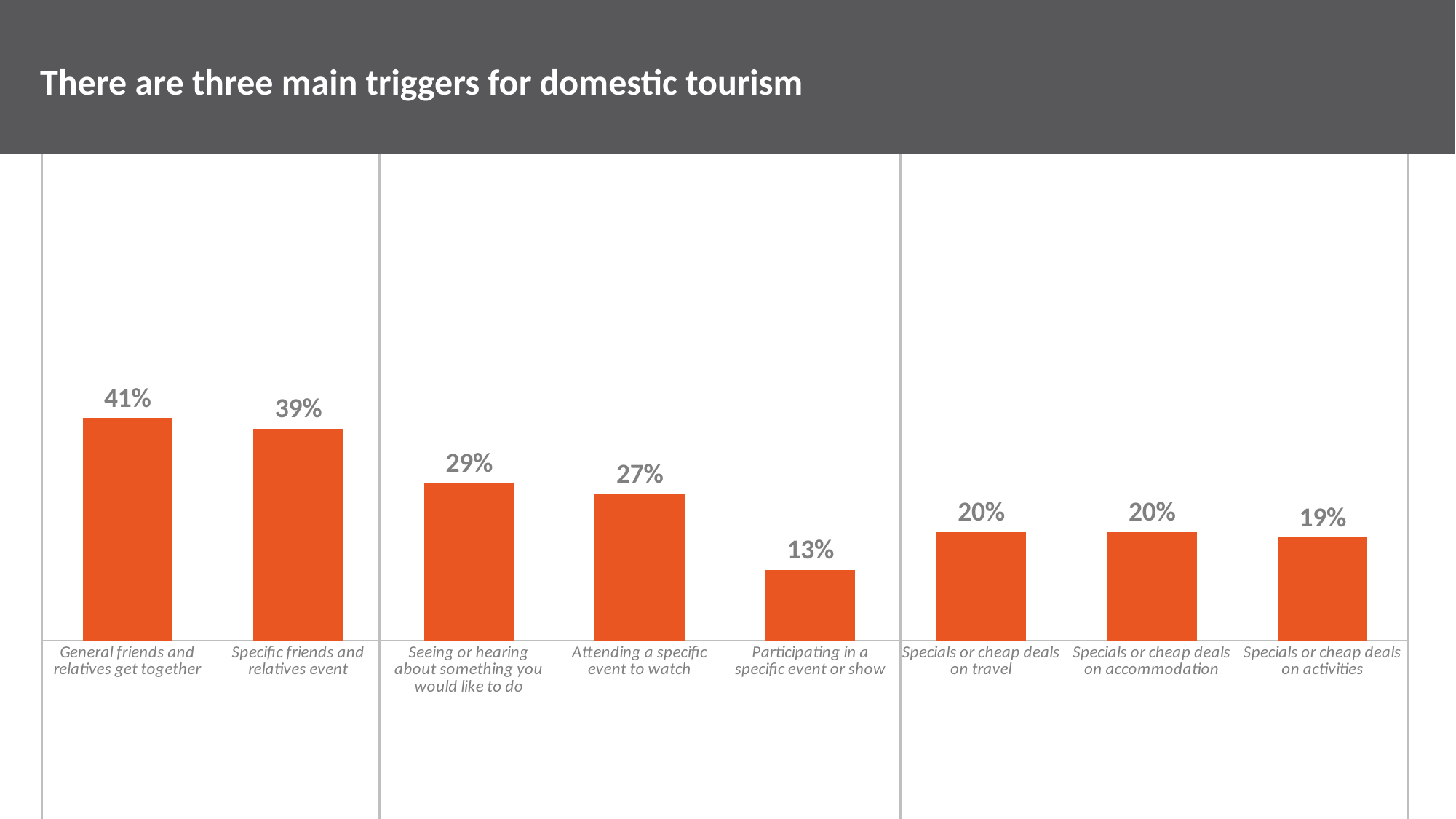
What kind of chart is shown on the slide? Bar chart Which category has the lowest value? Participating in a specific event or show Which category has the highest value? General friends and relatives get together How many categories are shown in the chart? 8 What is the value for 'General friends and relatives get together'? 41% What is the value for 'Participating in a specific event or show'? 13% What is the value for 'Specials or cheap deals on activities'? 19% What is the difference between 'General friends and relatives get together' and 'Specific friends and relatives event'? 2% What is the difference between 'Seeing or hearing about something you would like to do' and 'Participating in a specific event or show'? 16% What is the title of the slide? There are three main triggers for domestic tourism What is the value for 'Attending a specific event to watch'? 27% Which is larger: 'Attending a specific event to watch' or 'Specials or cheap deals on travel'? Attending a specific event to watch